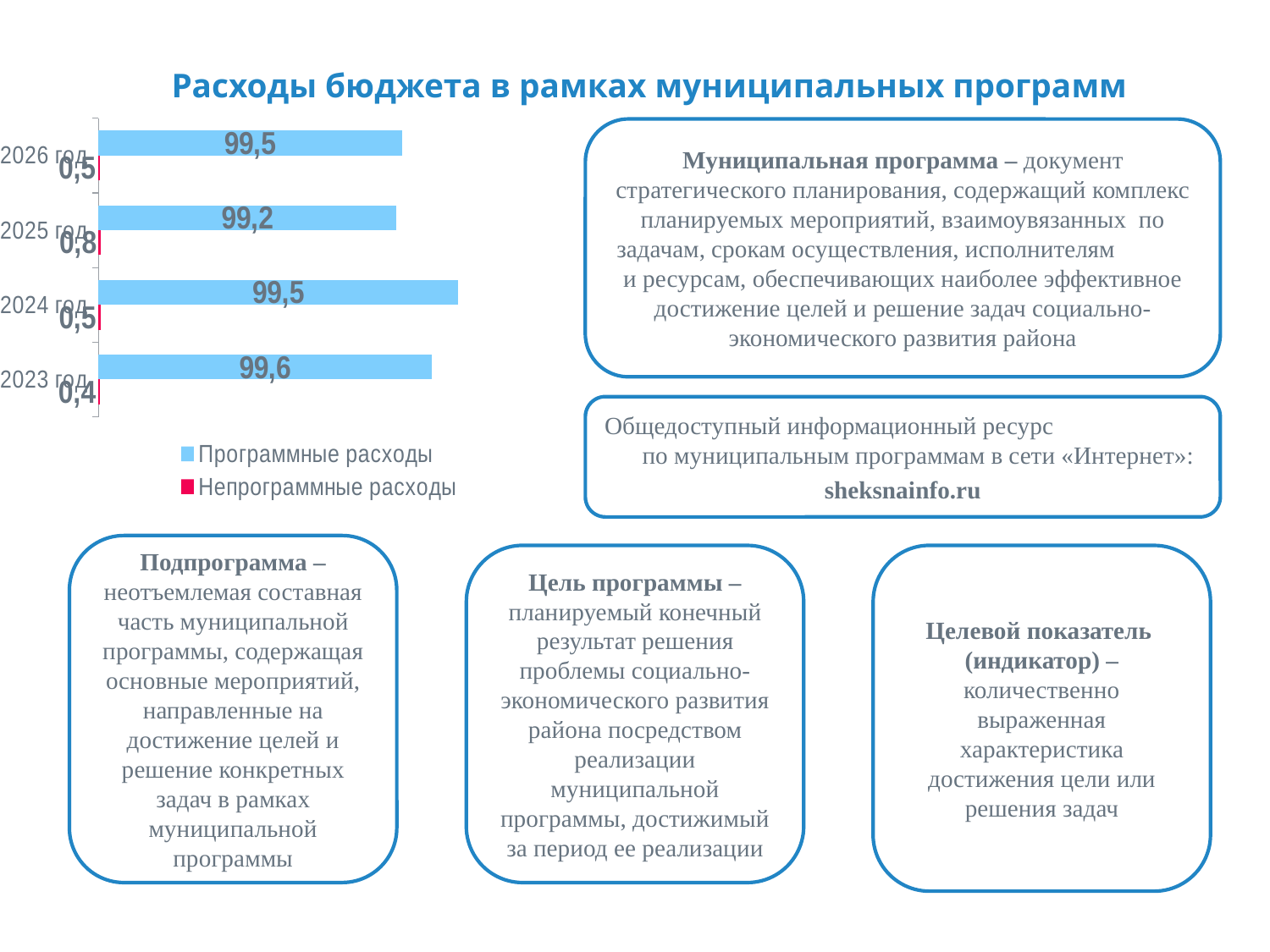
What is the difference between Программные расходы for 2023 год and 2025 год? 0,4 What is the value of Непрограммные расходы for 2025 год? 0,8 What is the value of Программные расходы for 2026 год? 99,5 Which year has the highest value of Непрограммные расходы? 2025 год Which is larger: Непрограммные расходы for 2025 год or for 2023 год? 2025 год How many series does the chart legend list? 2 Which year has the lowest value of Программные расходы? 2025 год What is the value of Программные расходы for 2023 год? 99,6 How many years (categories) are shown in the chart? 4 What type of chart is shown on the slide? bar chart What is the value of Непрограммные расходы for 2024 год? 0,5